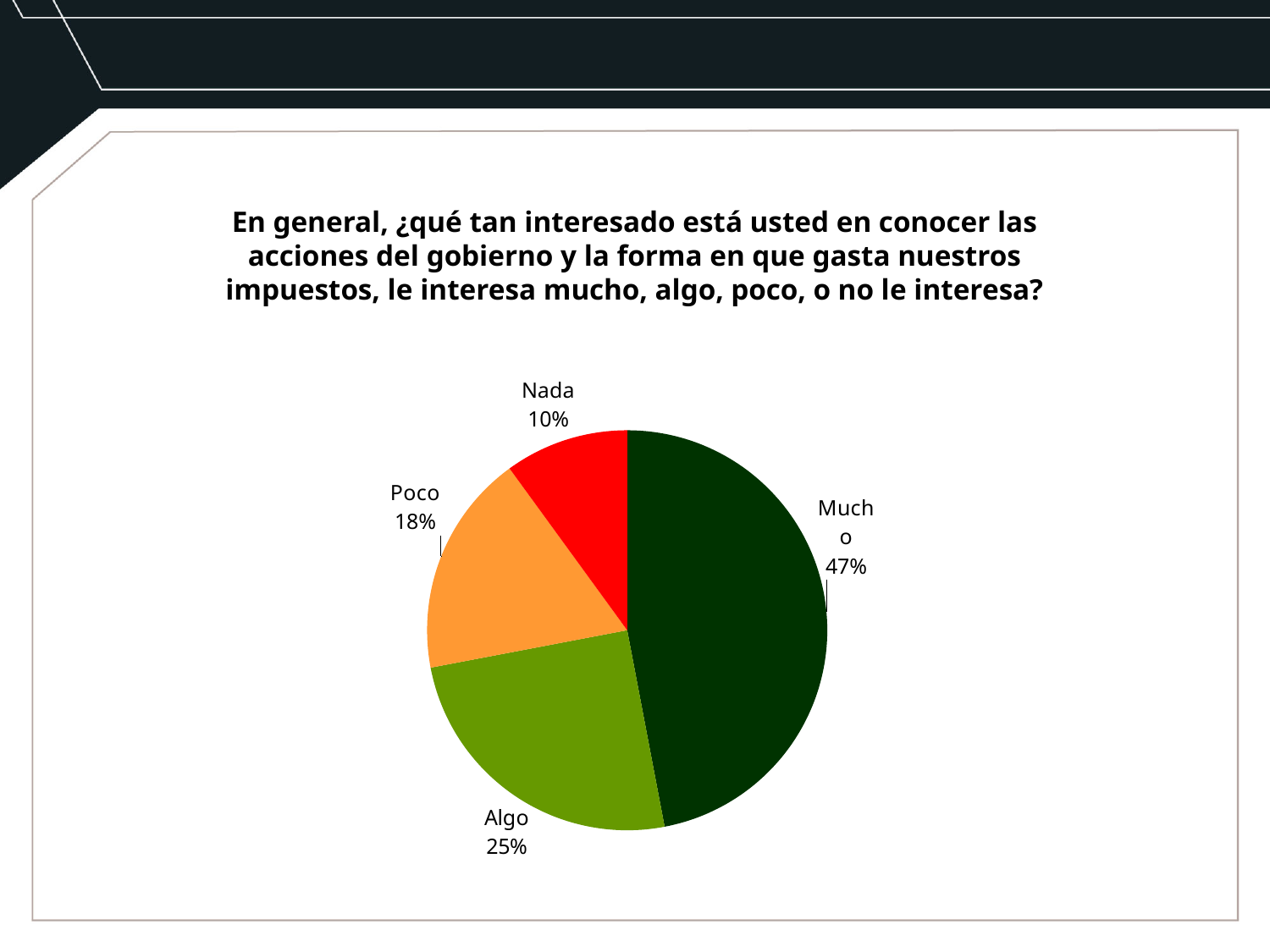
What kind of chart is shown on the slide? Pie chart What is the value shown for "Algo"? 25% Which category has the smallest slice of the pie? Nada Which is larger, the slice for "Algo" or the slice for "Poco"? Algo What share of the pie does the "Mucho" slice represent? 47% Which category has the largest slice of the pie? Mucho How many categories are shown in the pie chart? 4 What is the value shown for "Poco"? 18% What colour is the "Nada" slice? Red What is the difference in percentage points between "Poco" and "Nada"? 8 What is the difference in percentage points between "Mucho" and "Algo"? 22 What is the value shown for "Nada"? 10%